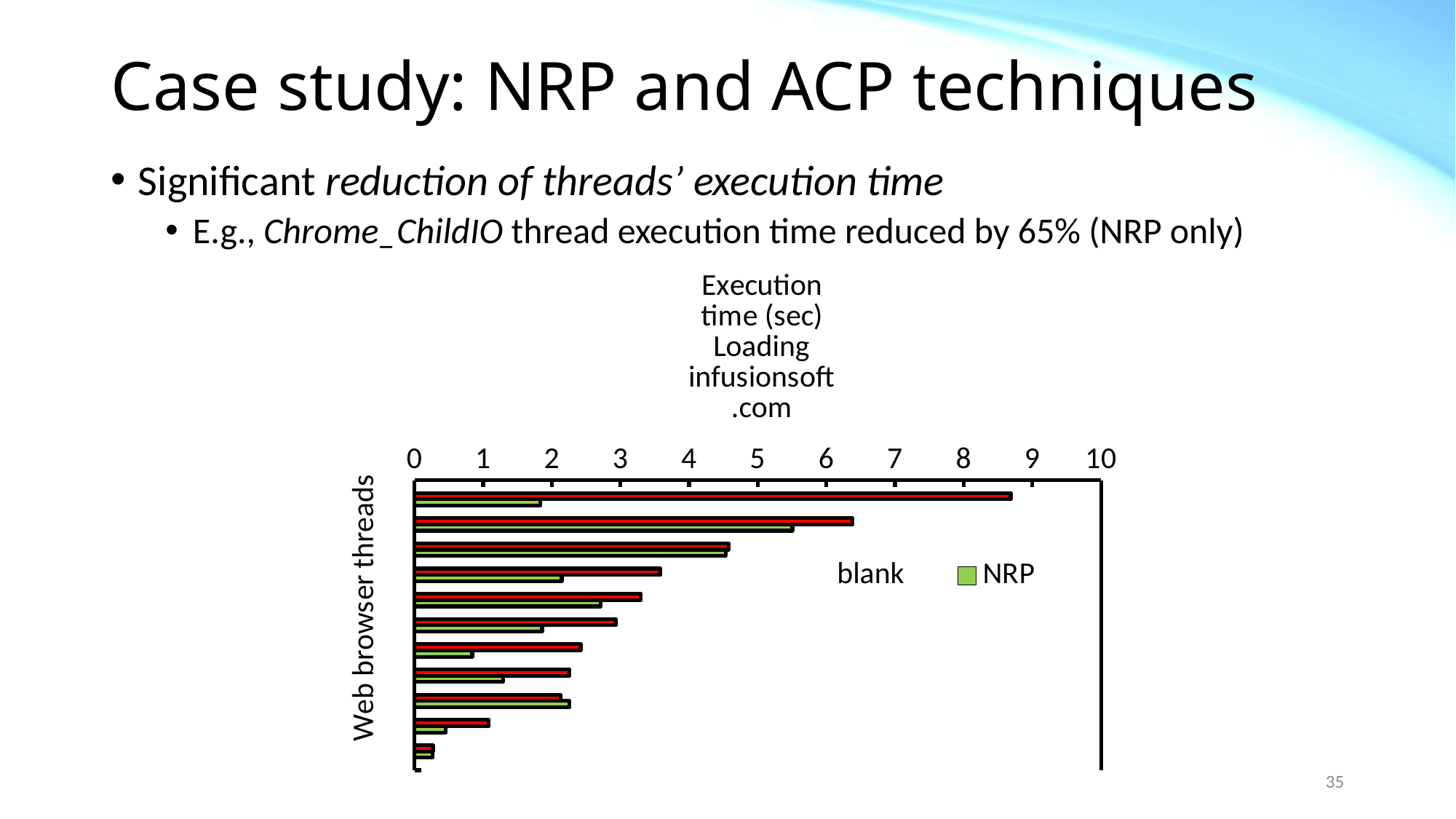
How many web browser threads (pairs of bars) are plotted in the chart? 11 What is the highest value shown on the chart's horizontal axis? 10 What is the title of the chart? Execution time (sec) Loading infusionsoft.com Is the NRP value for the topmost thread greater or less than 2? less How many series does the chart's legend list? 2 What are the two series named in the chart's legend? blank and NRP Is the longest NRP bar in the chart greater or less than 6? less What kind of chart is shown on the slide? bar chart